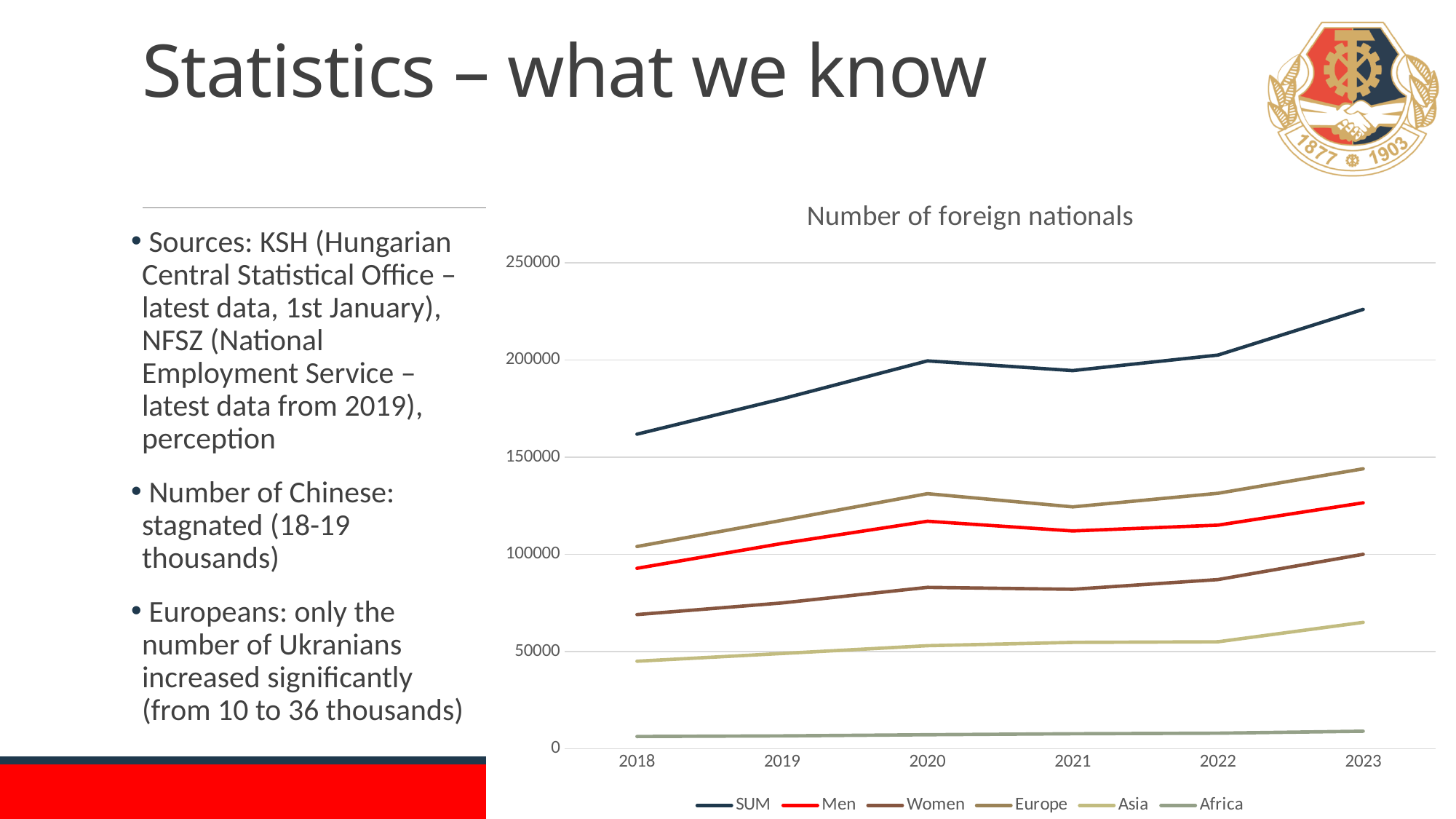
How many series does the chart legend list? 6 Is the value for Men in 2018 greater or less than 100000? less In 2023, which is larger, the value for Men or the value for Women? Men Is the value for Asia in 2023 greater or less than 50000? greater Is the value for Europe in 2023 greater or less than 150000? less Which series has the lowest values across all years? Africa In which year does the SUM series reach its highest value? 2023 What is the title of the chart? Number of foreign nationals How many years are plotted along the x axis? 6 Does the SUM series rise or fall overall from 2018 to 2023? rise What kind of chart is shown on the slide? line chart